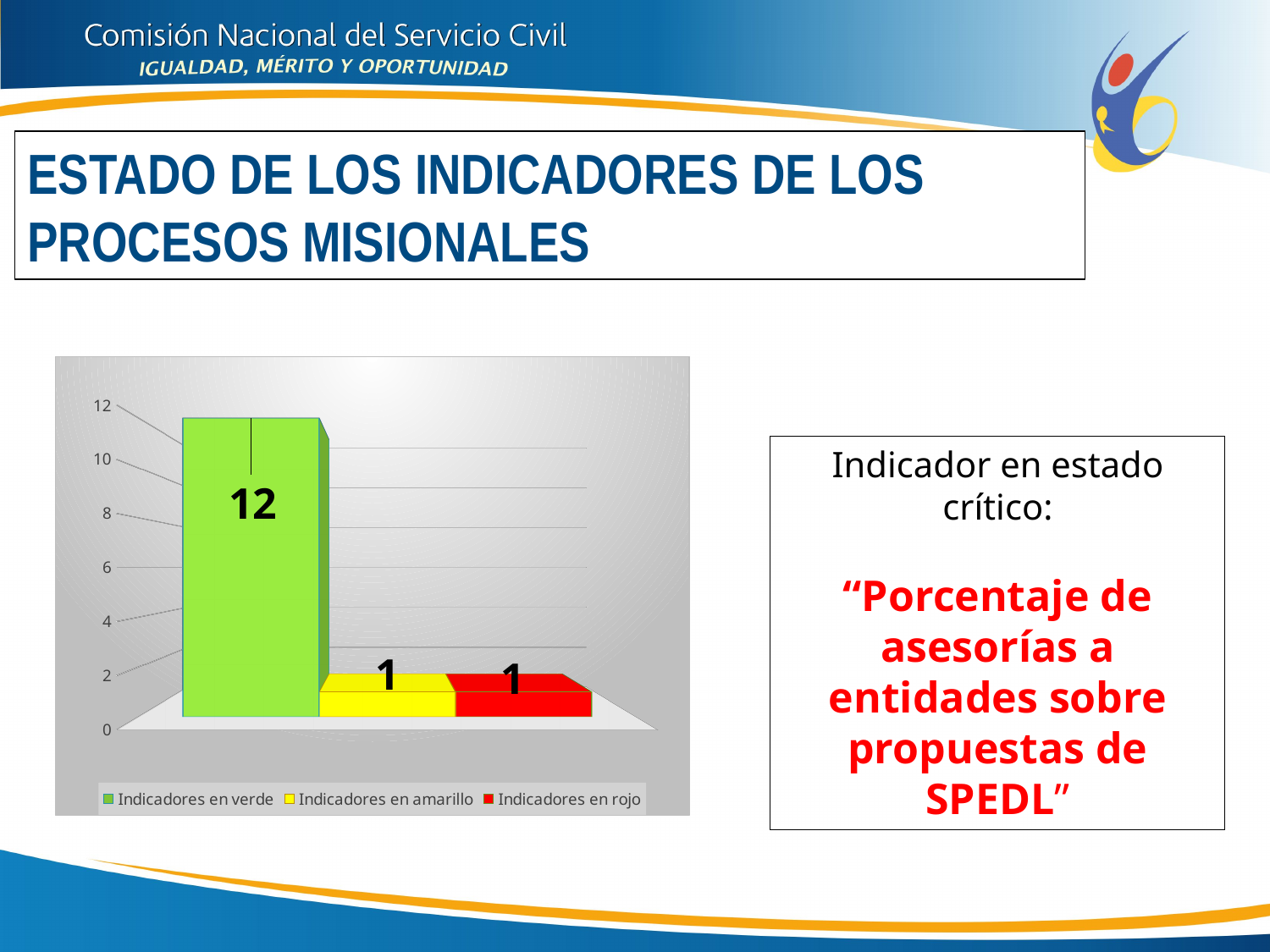
What is the value for Indicadores en rojo? 1 What is the total of all three series shown in the chart? 14 Which series has the highest value? Indicadores en verde What is the difference between Indicadores en verde and Indicadores en rojo? 11 What kind of chart is shown on the slide? Bar chart What is the value for Indicadores en verde? 12 What colour is the bar for Indicadores en rojo? Red Which is larger, Indicadores en verde or Indicadores en amarillo? Indicadores en verde How many series does the legend list? 3 What is the value for Indicadores en amarillo? 1 Is the value for Indicadores en amarillo greater or less than 2? less Is the value for Indicadores en verde greater or less than 10? greater